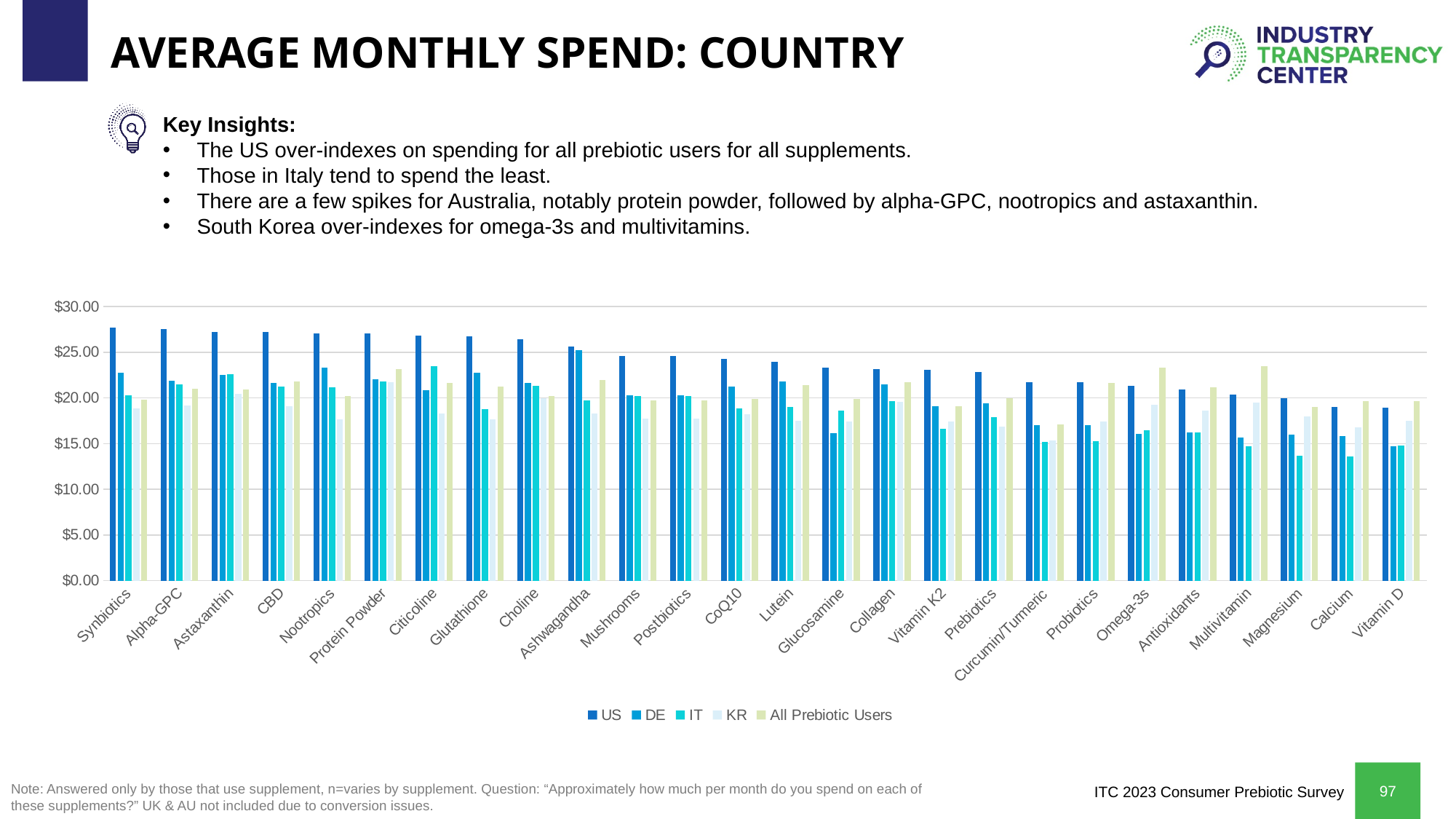
Is the US value for Synbiotics greater or less than $25.00? greater Do the US values generally rise or fall moving from left to right along the x axis? fall Is the KR value for Multivitamin greater or less than $15.00? greater What kind of chart is shown on the slide? Bar chart How many series does the legend list? 5 How many supplement categories are shown on the x axis? 26 For Synbiotics, which series has the highest bar? US Is the DE value for Glucosamine greater or less than $20.00? less What is the title of the chart's slide? AVERAGE MONTHLY SPEND: COUNTRY For Omega-3s, which is larger: the KR value or the IT value? KR